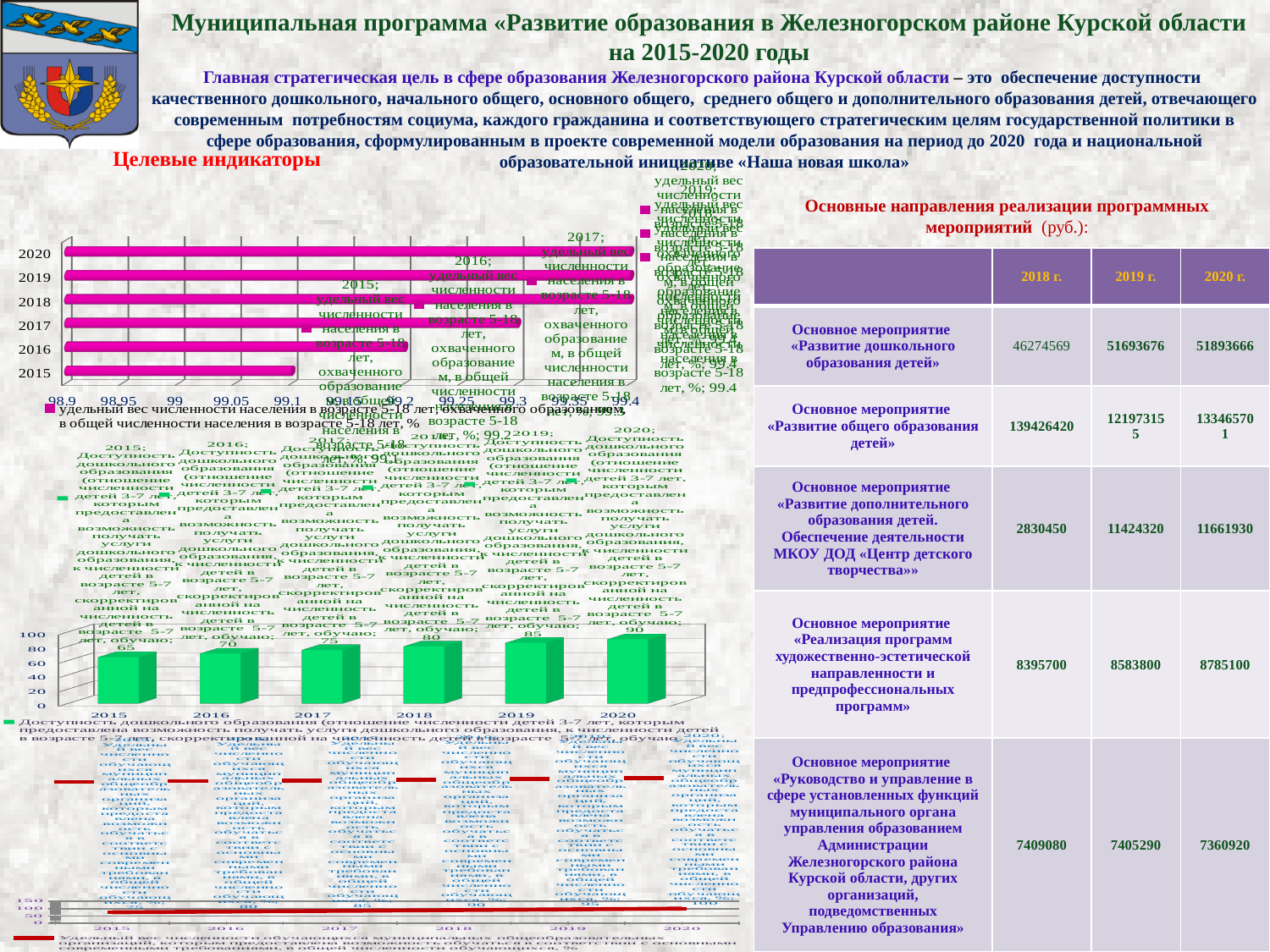
In the middle chart on the left (green bars), which year has the highest value? 2020 In the bottom chart on the left (red bars), which is larger, the value for 2018 or the value for 2015? 2018 In the bottom chart on the left (red bars), what is the difference between the values for 2020 and 2017? 15 In the middle chart on the left (green bars), how many years are plotted? 6 In the bottom chart on the left (red bars), what is the value for 2019? 95 In the middle chart on the left (green bars), do the values rise or fall from 2015 to 2020? rise In the middle chart on the left (green bars), which year has the lowest value? 2015 What kind of chart is the top chart on the left (magenta bars)? bar chart In the bottom chart on the left (red bars), what is the value for 2016? 80 In the middle chart on the left (green bars), what is the value for 2020? 90 In the middle chart on the left (green bars), what is the value for 2015? 65 In the middle chart on the left (green bars), what is the difference between the values for 2020 and 2015? 25